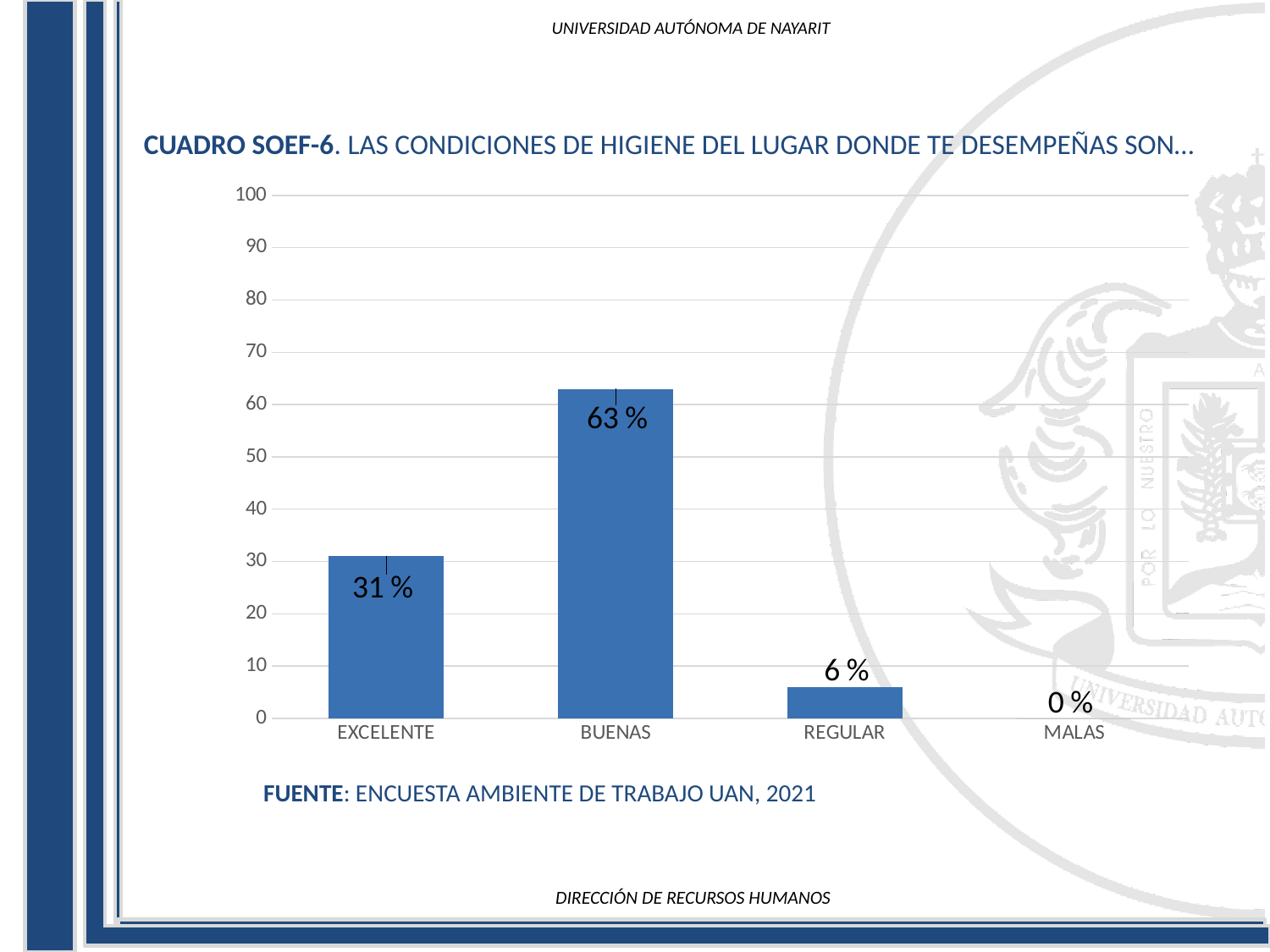
What is the value for MALAS? 0 % What is the value for REGULAR? 6 % What is the difference between the values for BUENAS and EXCELENTE? 32 % Is the value for BUENAS greater or less than 50? greater What is the value for BUENAS? 63 % What kind of chart is shown on the slide? bar chart Which category has the highest value? BUENAS What is the value for EXCELENTE? 31 % How many categories are shown on the x axis? 4 Which is larger, the value for EXCELENTE or the value for REGULAR? EXCELENTE What source is cited below the chart? ENCUESTA AMBIENTE DE TRABAJO UAN, 2021 Which category has the lowest value? MALAS